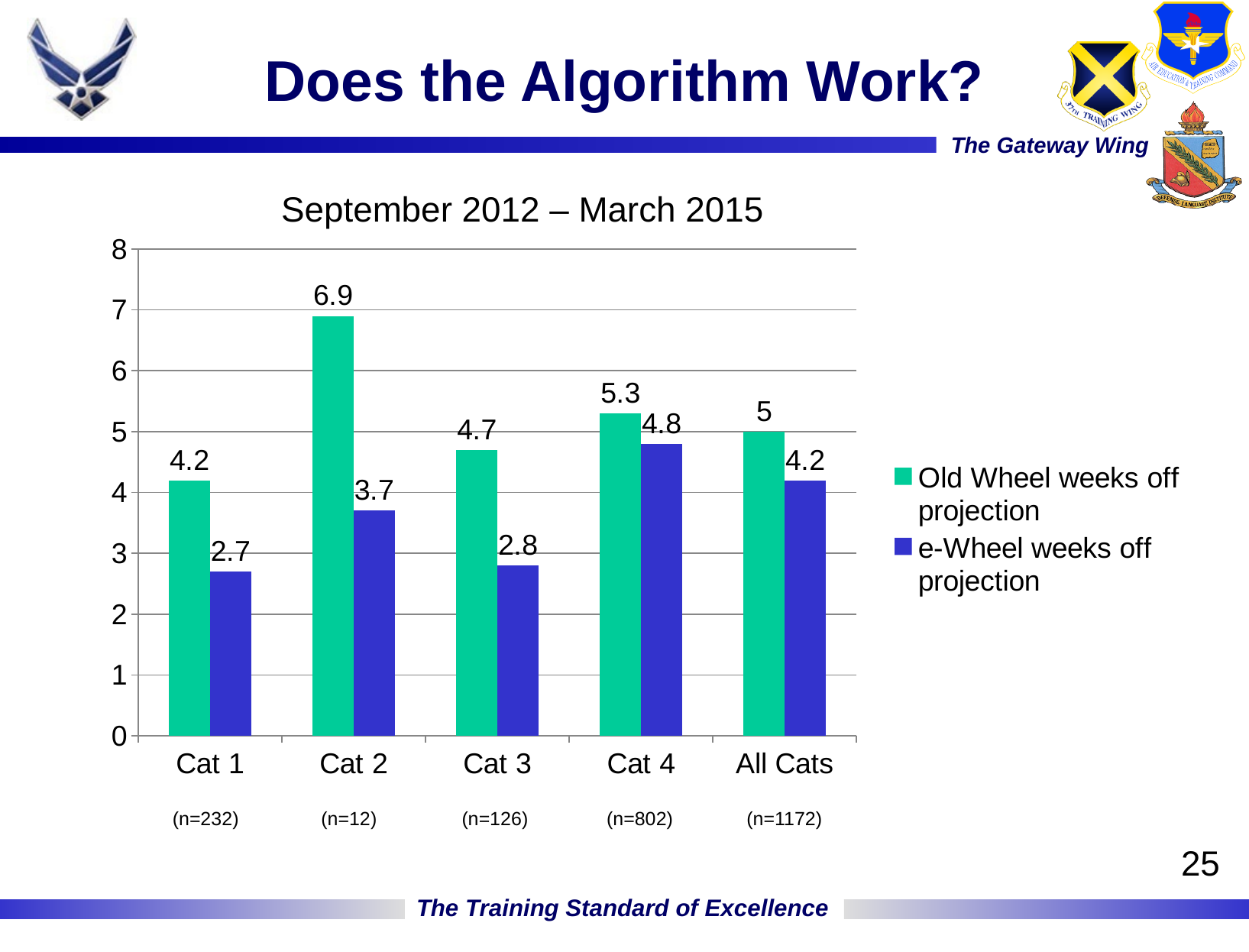
Is the Old Wheel weeks off projection for Cat 3 greater or less than 4? greater What is the difference between the Old Wheel and e-Wheel weeks off projections for Cat 2? 3.2 Which category has the highest Old Wheel weeks off projection? Cat 2 What kind of chart is shown on the slide? Bar chart What is the title of the chart? September 2012 – March 2015 What is the e-Wheel weeks off projection for All Cats? 4.2 Which category has the lowest e-Wheel weeks off projection? Cat 1 How many series does the legend list? 2 What is the Old Wheel weeks off projection for Cat 2? 6.9 Which is larger for Cat 4: the Old Wheel weeks off projection or the e-Wheel weeks off projection? Old Wheel weeks off projection How many categories are shown on the x axis? 5 What is the e-Wheel weeks off projection for Cat 1? 2.7